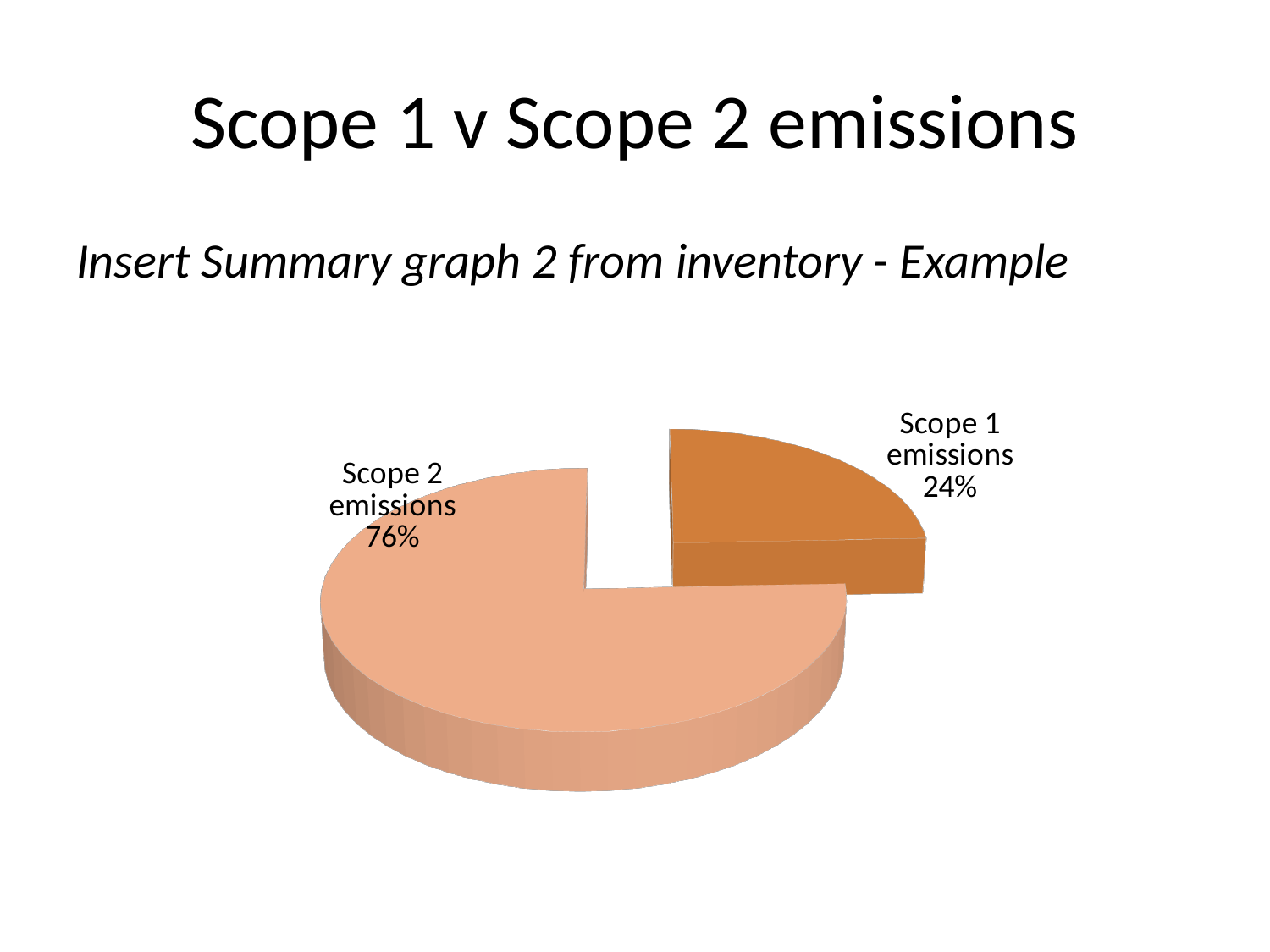
What is the title of the slide containing the chart? Scope 1 v Scope 2 emissions How many slices does the pie chart have? 2 What share of the pie is Scope 2 emissions? 76% Which slice of the pie is the smallest? Scope 1 emissions What kind of chart is shown on the slide? Pie chart Which slice of the pie is the largest? Scope 2 emissions Which is larger, Scope 1 emissions or Scope 2 emissions? Scope 2 emissions What is the difference in percentage points between Scope 2 emissions and Scope 1 emissions? 52 Which slice is pulled out (exploded) from the pie? Scope 1 emissions What share of the pie is Scope 1 emissions? 24%